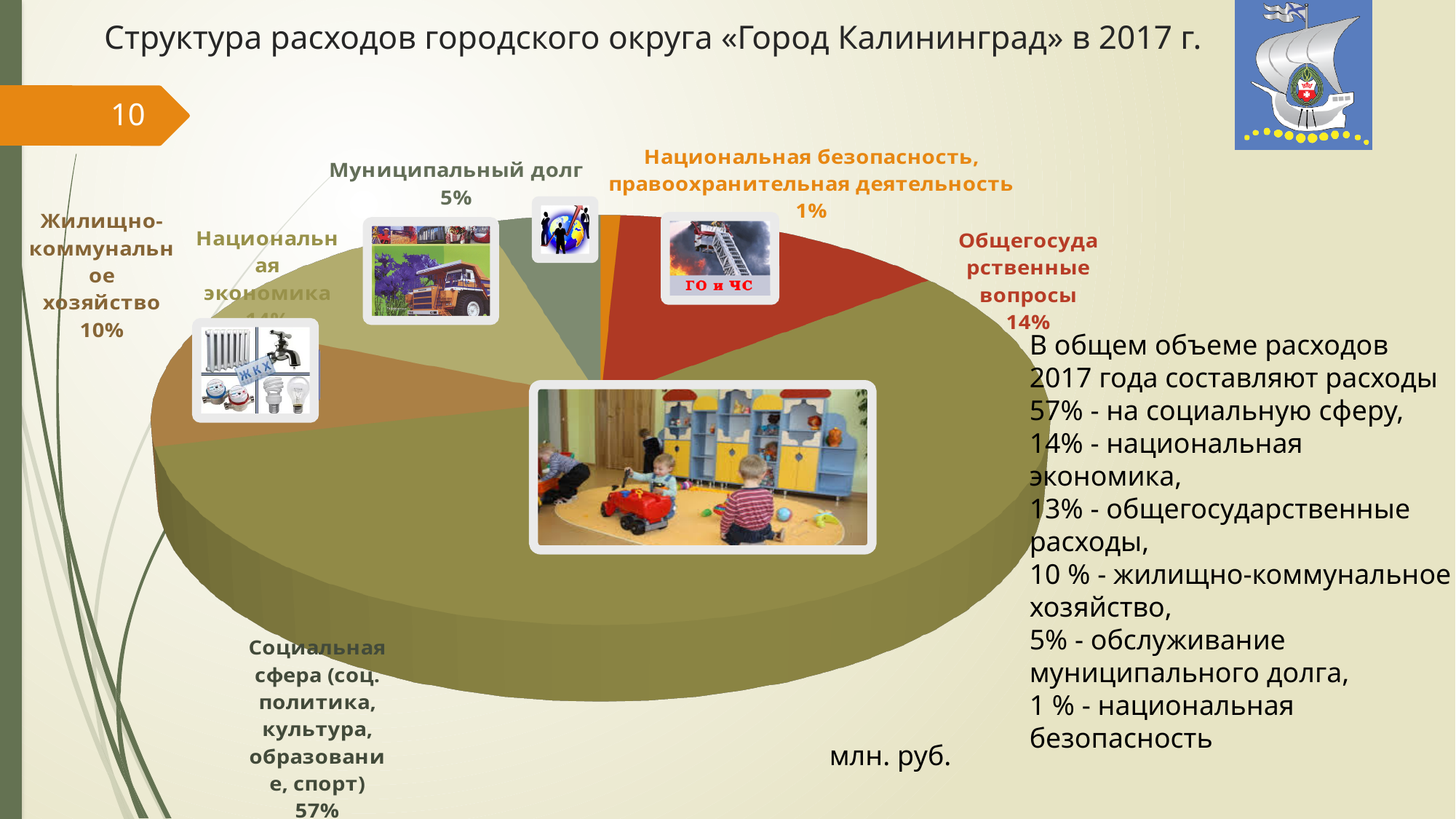
What share of expenditures does "Муниципальный долг" represent? 5% What kind of chart is shown on the slide? pie chart Which is larger: the share for "Жилищно-коммунальное хозяйство" or for "Муниципальный долг"? Жилищно-коммунальное хозяйство Which category has the largest slice of the pie? Социальная сфера (соц. политика, культура, образование, спорт) By how many percentage points does the share of "Социальная сфера" exceed the share of "Жилищно-коммунальное хозяйство"? 47 percentage points What is the title of the slide containing the chart? Структура расходов городского округа «Город Калининград» в 2017 г. What share of expenditures does the slice "Социальная сфера (соц. политика, культура, образование, спорт)" represent? 57% What share of expenditures does "Жилищно-коммунальное хозяйство" represent? 10% How many categories (slices) does the pie chart have? 6 Which category has the smallest slice of the pie? Национальная безопасность, правоохранительная деятельность What unit is indicated below the chart? млн. руб.